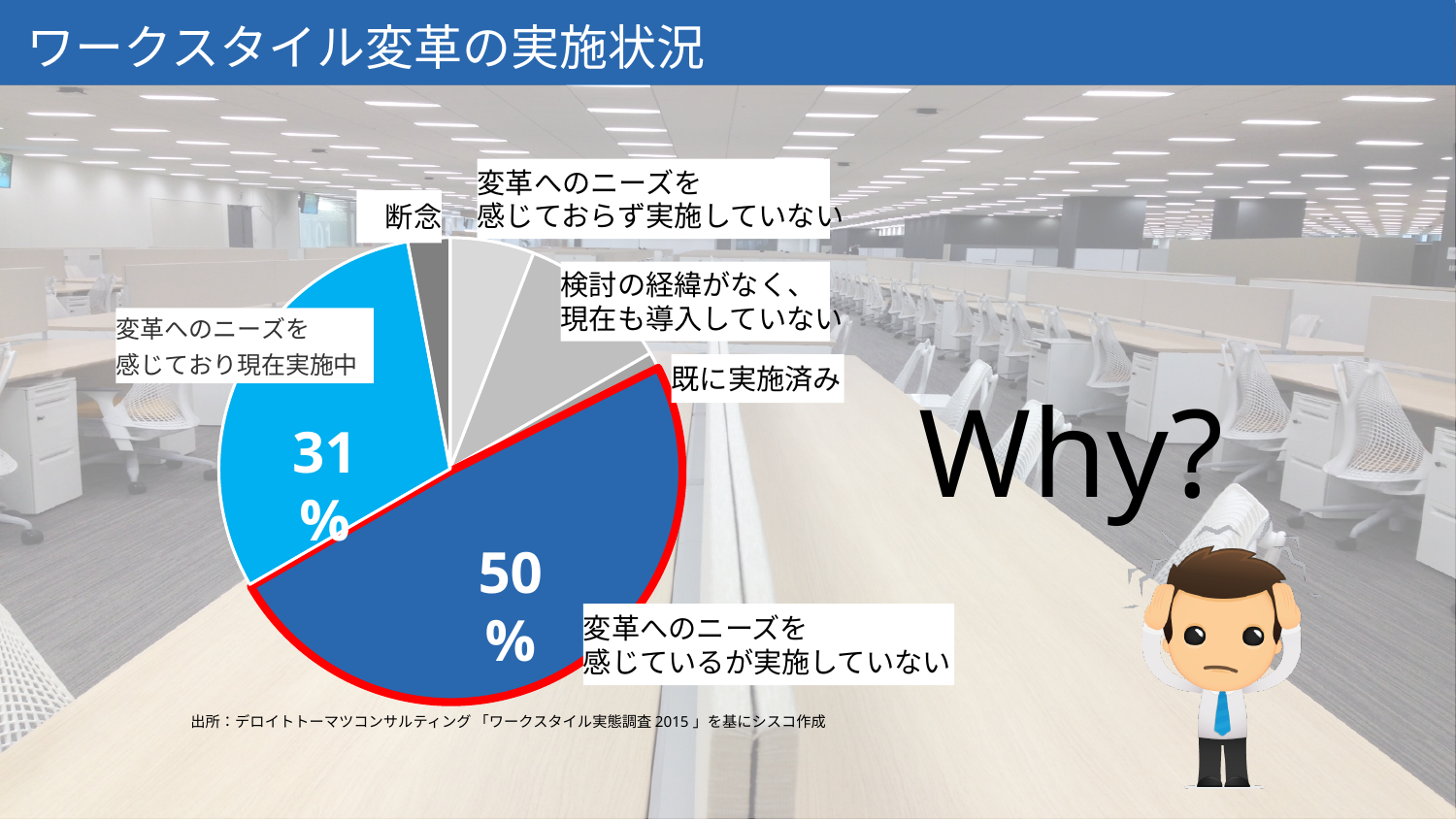
What kind of chart is shown on the slide? pie chart What is the value for 変革へのニーズを感じているが実施していない? 50% What is the value for 変革へのニーズを感じており現在実施中? 31% Which slice of the pie is outlined in red? 変革へのニーズを感じているが実施していない What is the title of the slide containing the chart? ワークスタイル変革の実施状況 Which category has the largest slice of the pie? 変革へのニーズを感じているが実施していない How many slices does the pie chart have? 6 What is the difference in percentage points between the 変革へのニーズを感じているが実施していない slice and the 変革へのニーズを感じており現在実施中 slice? 19 Which is larger, the slice for 変革へのニーズを感じており現在実施中 or the slice for 既に実施済み? 変革へのニーズを感じており現在実施中 Which is larger, the slice for 変革へのニーズを感じており現在実施中 or the slice for 変革へのニーズを感じているが実施していない? 変革へのニーズを感じているが実施していない What share of the pie does the 変革へのニーズを感じているが実施していない slice represent? 50%